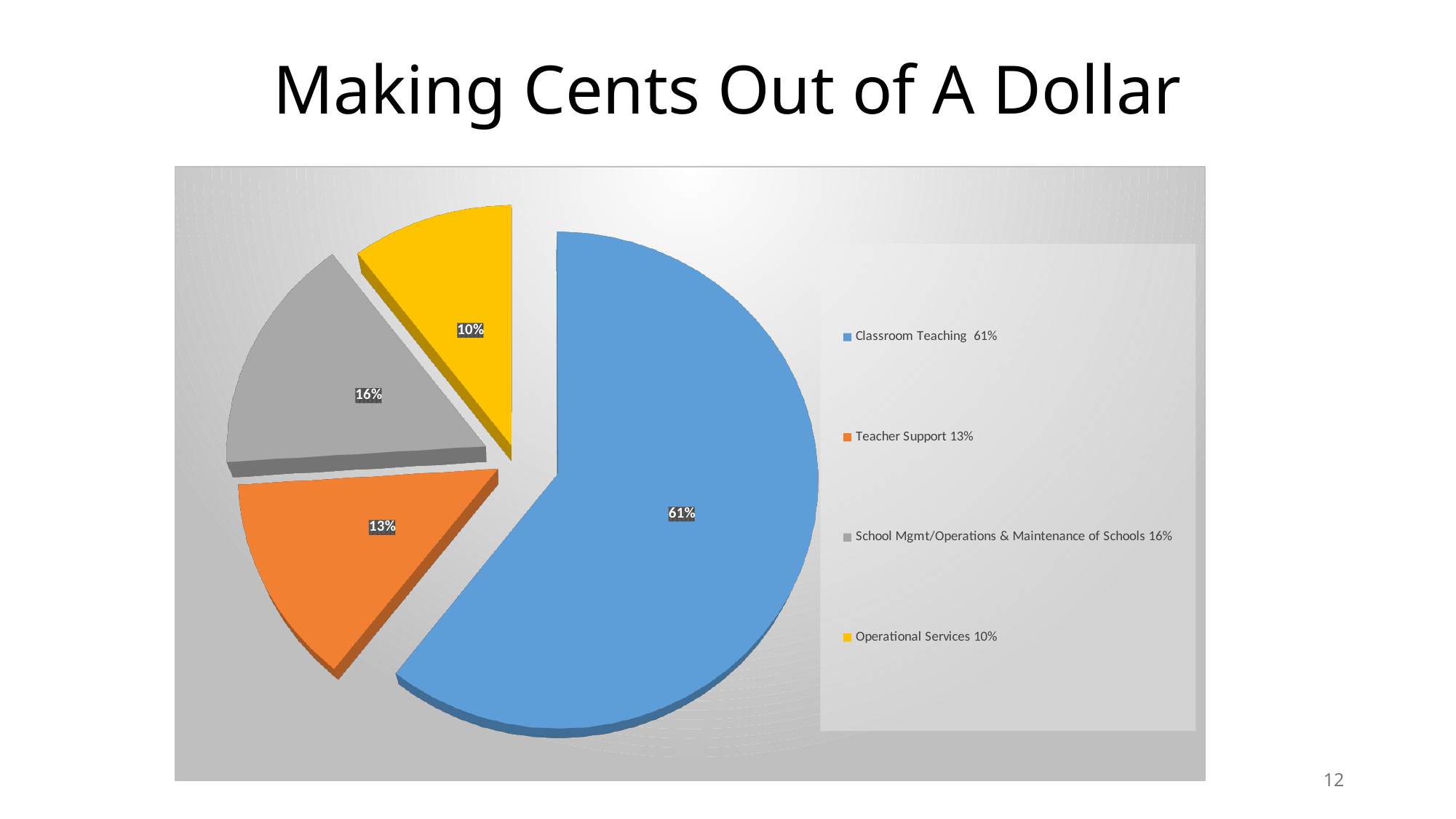
Which category has the largest slice of the pie? Classroom Teaching What colour is the slice for Operational Services? Yellow What share of the pie does Classroom Teaching take? 61% What is the title of the slide containing the pie chart? Making Cents Out of A Dollar What share of the pie does Operational Services take? 10% What is the difference in percentage points between Classroom Teaching and Teacher Support? 48 What share of the pie does School Mgmt/Operations & Maintenance of Schools take? 16% Which category has the smallest slice of the pie? Operational Services What kind of chart is shown on the slide? Pie chart How many slices does the pie chart have? 4 Which is larger, the share for Teacher Support or the share for School Mgmt/Operations & Maintenance of Schools? School Mgmt/Operations & Maintenance of Schools